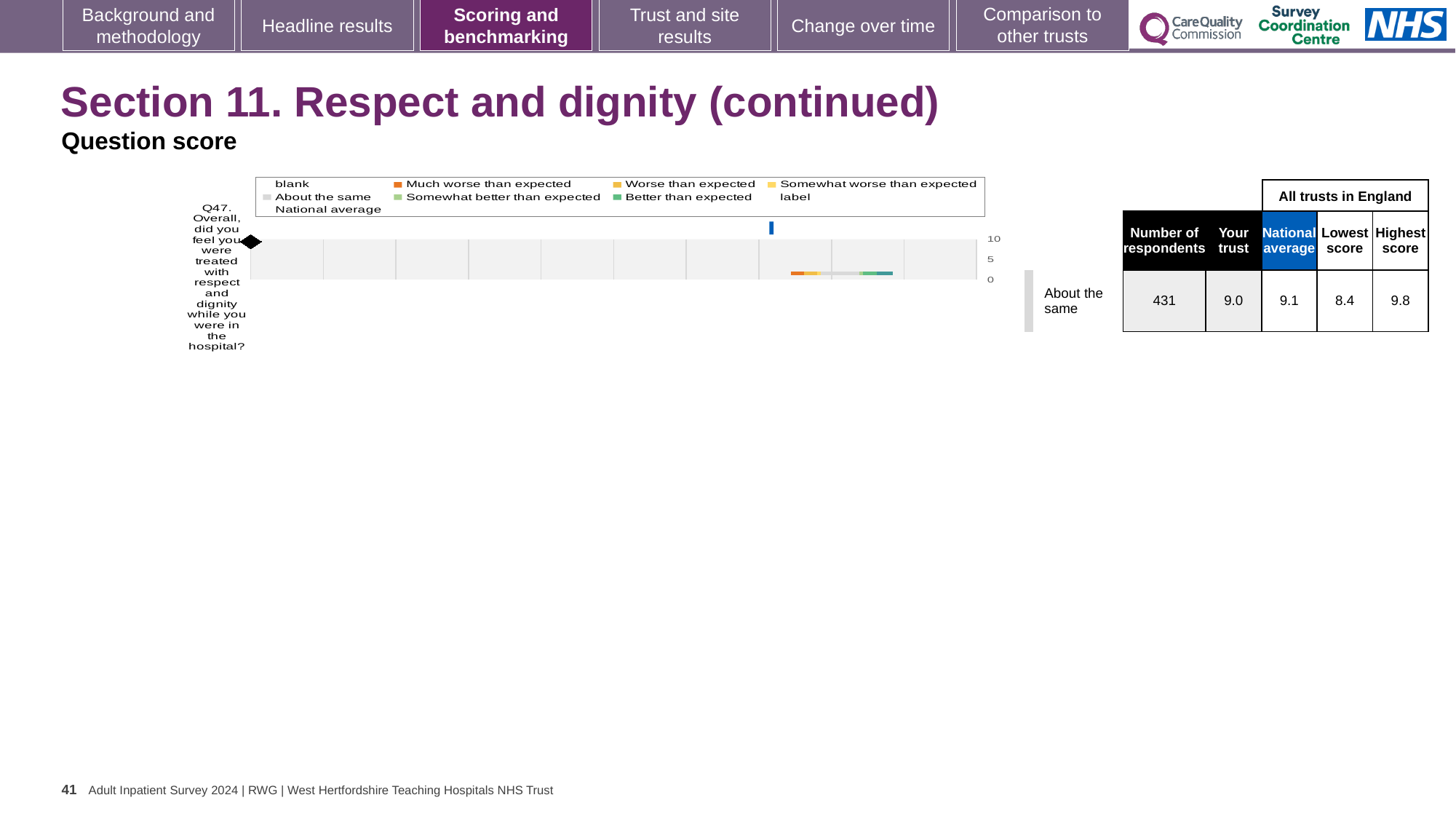
What is the 'Your trust' score shown for Q47 in the table next to the chart? 9.0 Which is larger for Q47, the trust score or the national average? National average What is the difference between the highest score and the lowest score for Q47? 1.4 What is the difference between the national average and the trust score for Q47? 0.1 How many questions are plotted on the chart? 1 How many respondents are shown for Q47? 431 What is the maximum value shown on the chart's axis? 10 What is the lowest score among all trusts in England shown for Q47? 8.4 What is the highest score among all trusts in England shown for Q47? 9.8 What benchmark category is the trust placed in for Q47? About the same What kind of chart is shown on the slide? Bar chart What is the national average score shown for Q47? 9.1